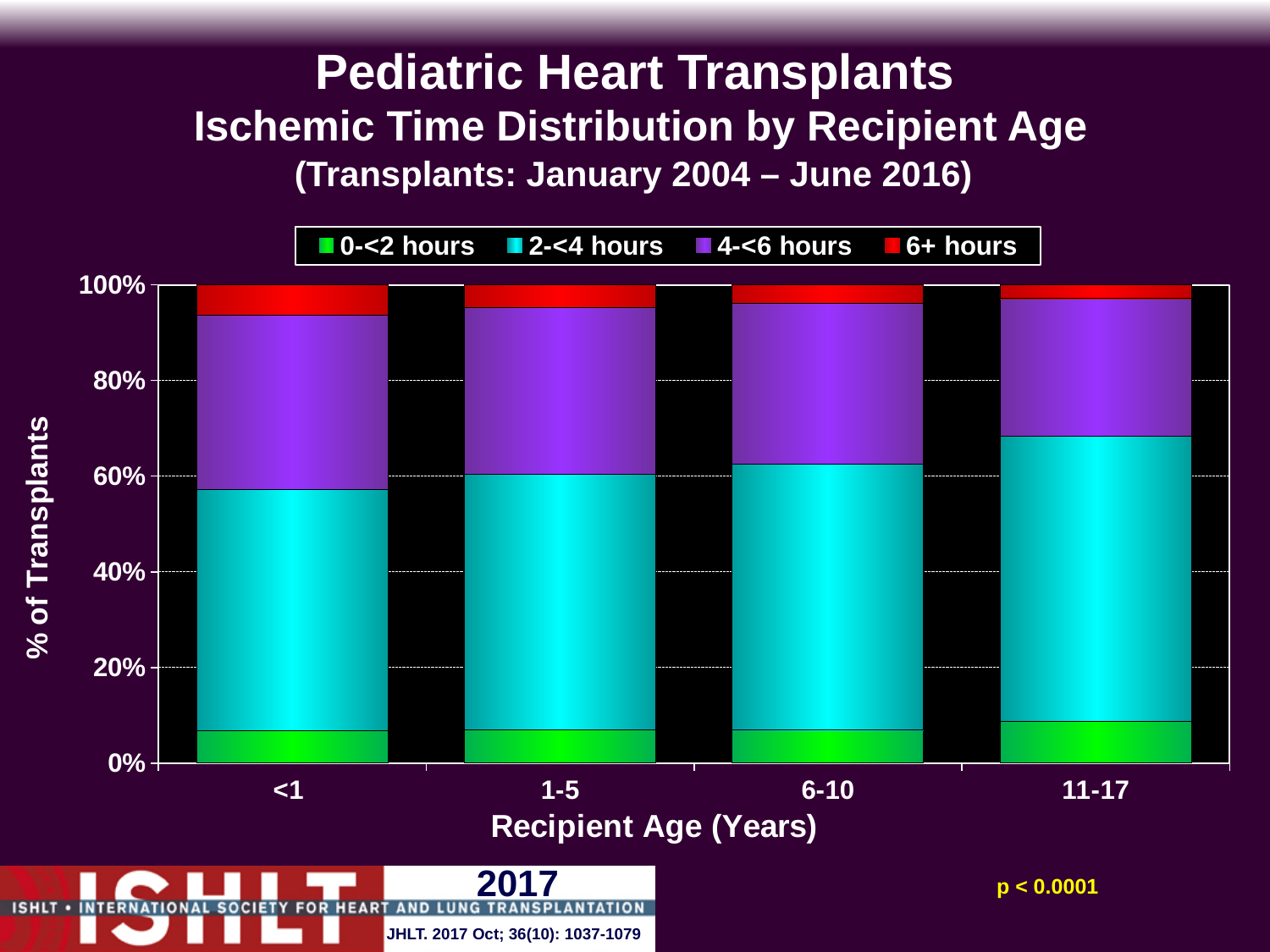
Which recipient age group has the smallest share of transplants with an ischemic time of 6+ hours? 11-17 What kind of chart is shown on the slide? Stacked bar chart What is the label of the y axis? % of Transplants Which recipient age group has the largest share of transplants with an ischemic time of 2-<4 hours? 11-17 Is the share of transplants with an ischemic time of 0-<2 hours for the 11-17 age group greater or less than 20%? less Which legend entry is shown in red? 6+ hours What does each stacked bar total? 100% How many recipient age groups are shown on the x axis? 4 Does the share of transplants with an ischemic time of 4-<6 hours rise or fall as recipient age increases from <1 to 11-17? fall Which recipient age group has the largest share of transplants with an ischemic time of 4-<6 hours? <1 Is the combined share of transplants with an ischemic time under 4 hours for the 11-17 age group greater or less than 60%? greater How many ischemic time categories does the legend list? 4